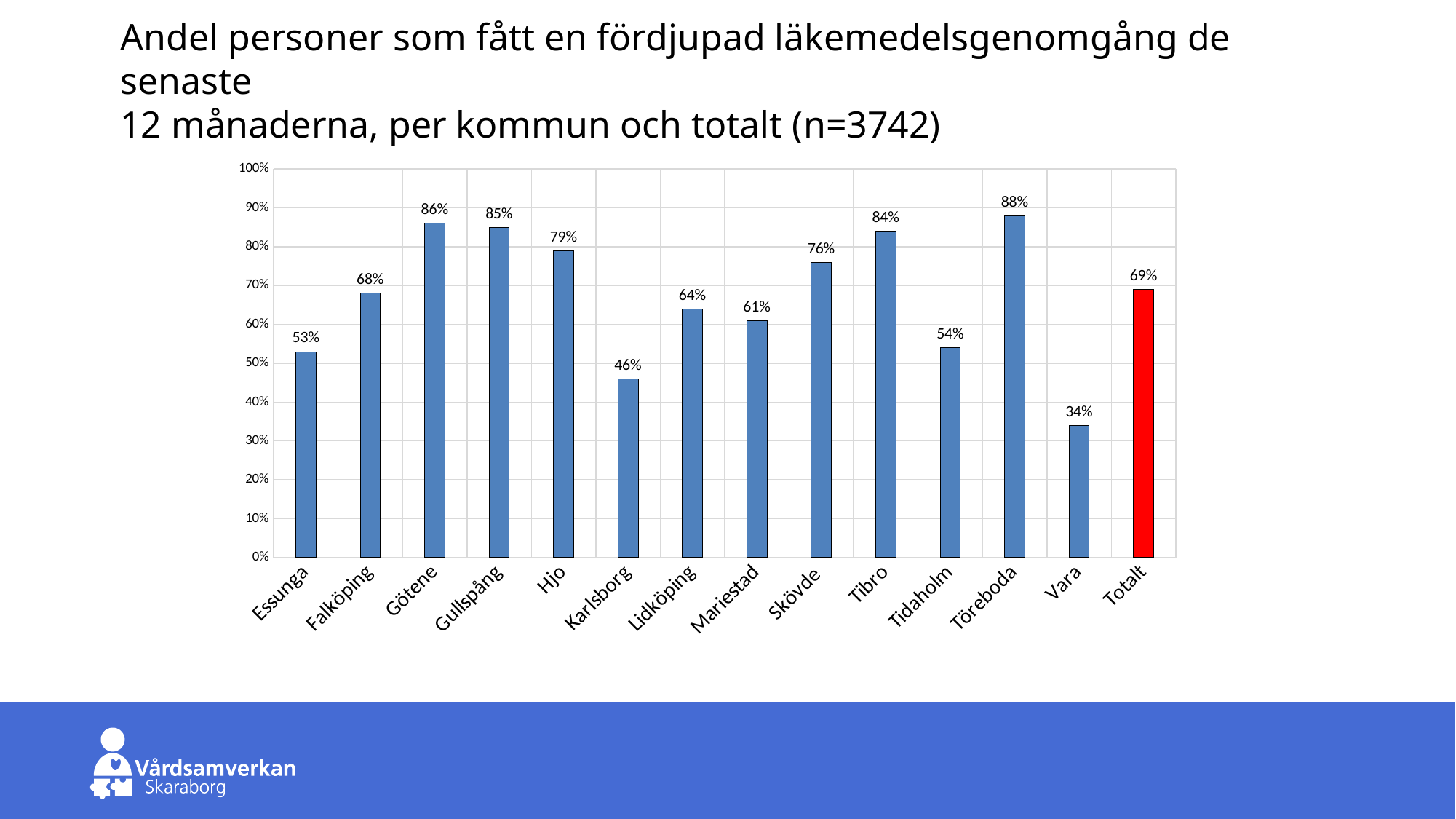
What is the difference between the values for Hjo and Essunga? 26 percentage points Which municipality has the highest value? Töreboda What is the value for Karlsborg? 46% What is the value for Götene? 86% What kind of chart is shown on the slide? Bar chart Which bar is coloured red? Totalt Which is larger, the value for Skövde or the value for Lidköping? Skövde What is the difference between the values for Töreboda and Vara? 54 percentage points How many bars are shown in the chart? 14 Is the value for Tidaholm greater or less than 60%? less What is the value for Totalt? 69% Which municipality has the lowest value? Vara